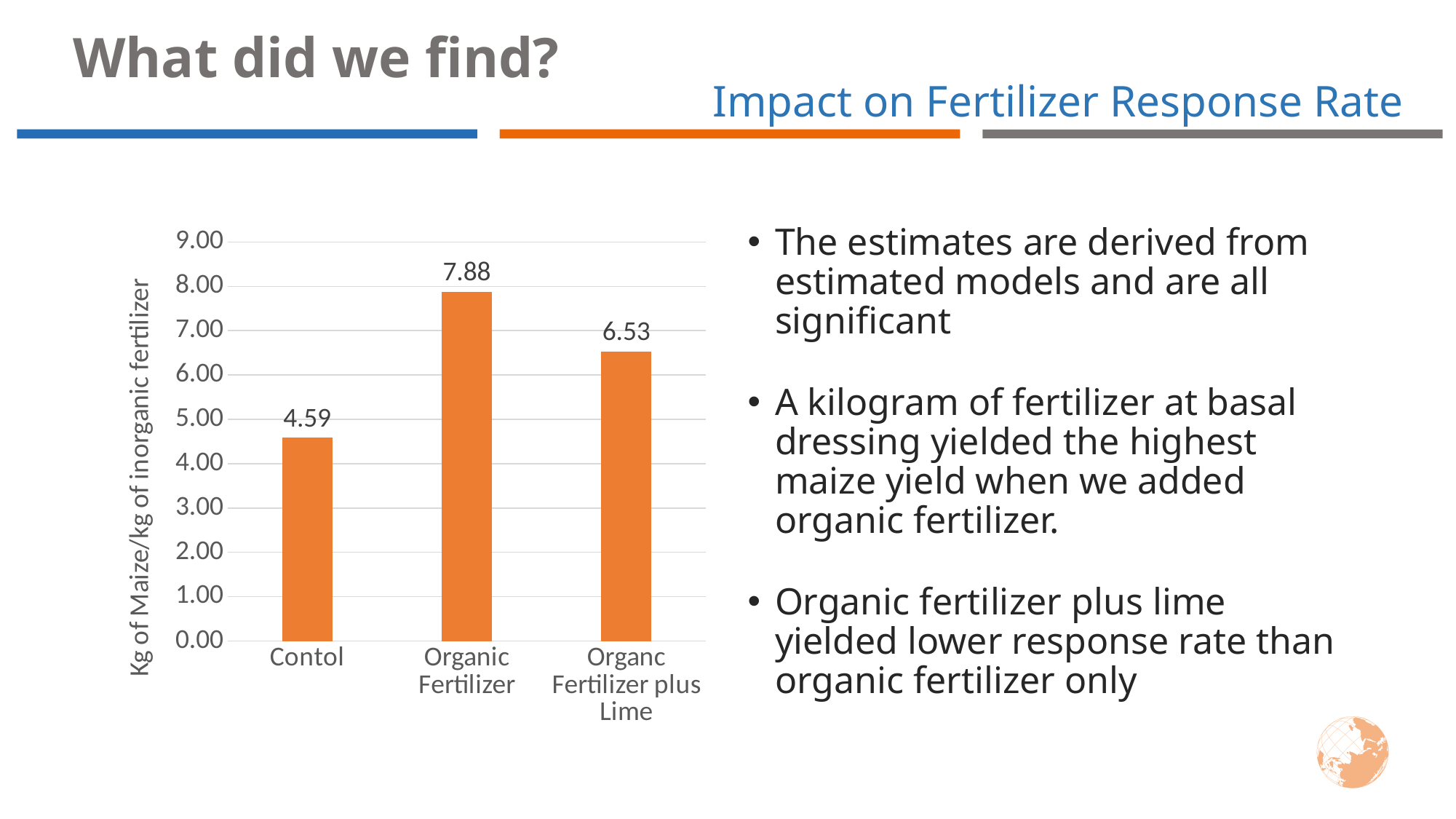
What kind of chart is shown on the slide? bar chart Which category has the lowest value? Contol Which is larger, the value for Organc Fertilizer plus Lime or the value for Contol? Organc Fertilizer plus Lime What is the value for Organc Fertilizer plus Lime? 6.53 What is the value for Contol? 4.59 Is the value for Contol greater or less than 5.00? less Which category has the highest value? Organic Fertilizer What is the difference between the values for Organic Fertilizer and Organc Fertilizer plus Lime? 1.35 What is the label of the vertical axis? Kg of Maize/kg of inorganic fertilizer What is the value for Organic Fertilizer? 7.88 How many categories are shown on the x axis? 3 What is the difference between the values for Organic Fertilizer and Contol? 3.29